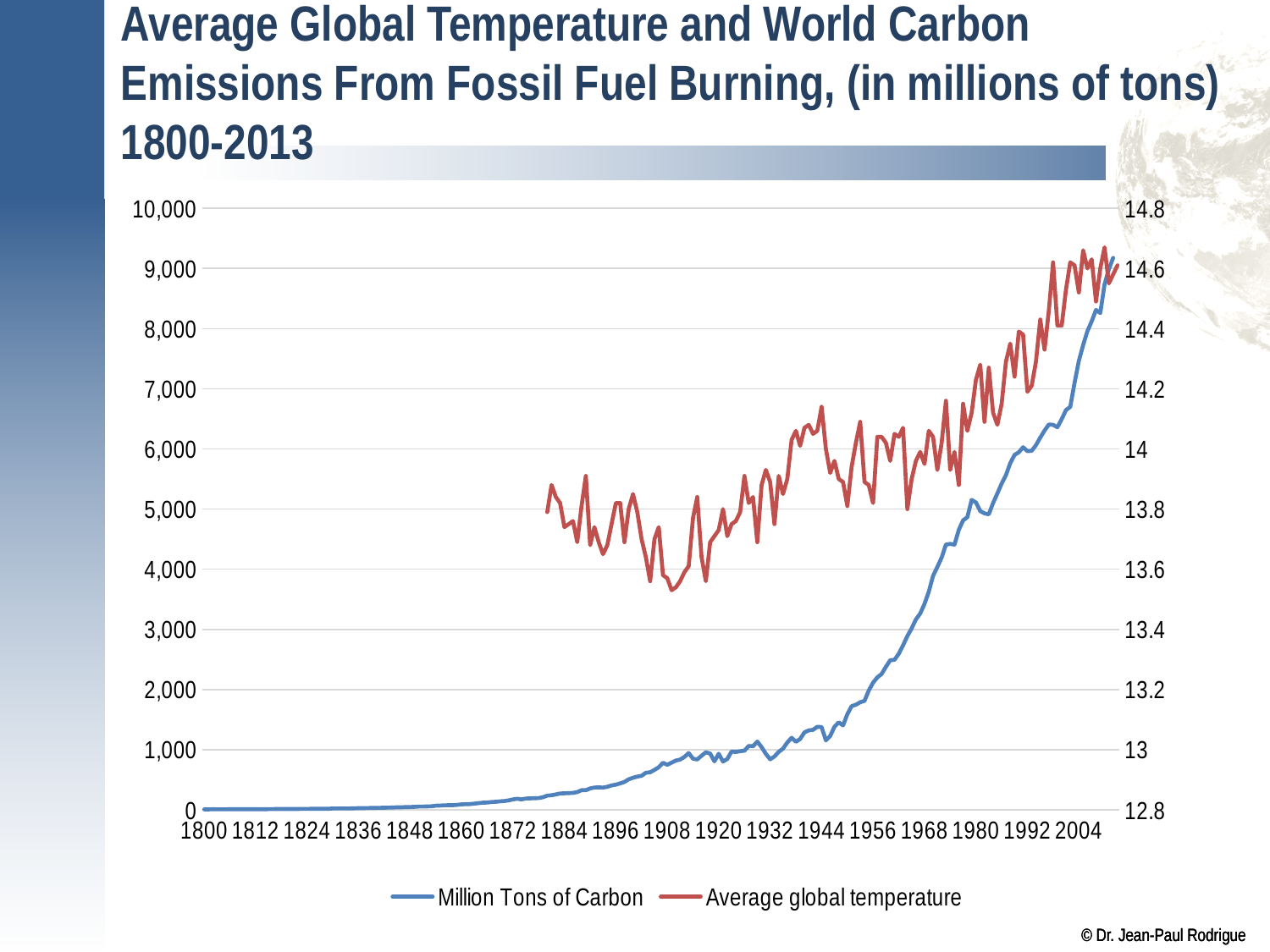
Is the value for Million Tons of Carbon in 2004 greater or less than 7,000? greater How many series does the legend list? 2 Which colour is used for the Average global temperature line? Red Is the value for Average global temperature in 2004 greater or less than 14.4? greater What kind of chart is shown on the slide? Line chart Is the value for Million Tons of Carbon in 1932 greater or less than 2,000? less Does the Average global temperature line generally rise or fall from 1884 to 2004? Rise Does the Million Tons of Carbon line generally rise or fall from 1800 to 2004? Rise What are the two series named in the legend? Million Tons of Carbon; Average global temperature